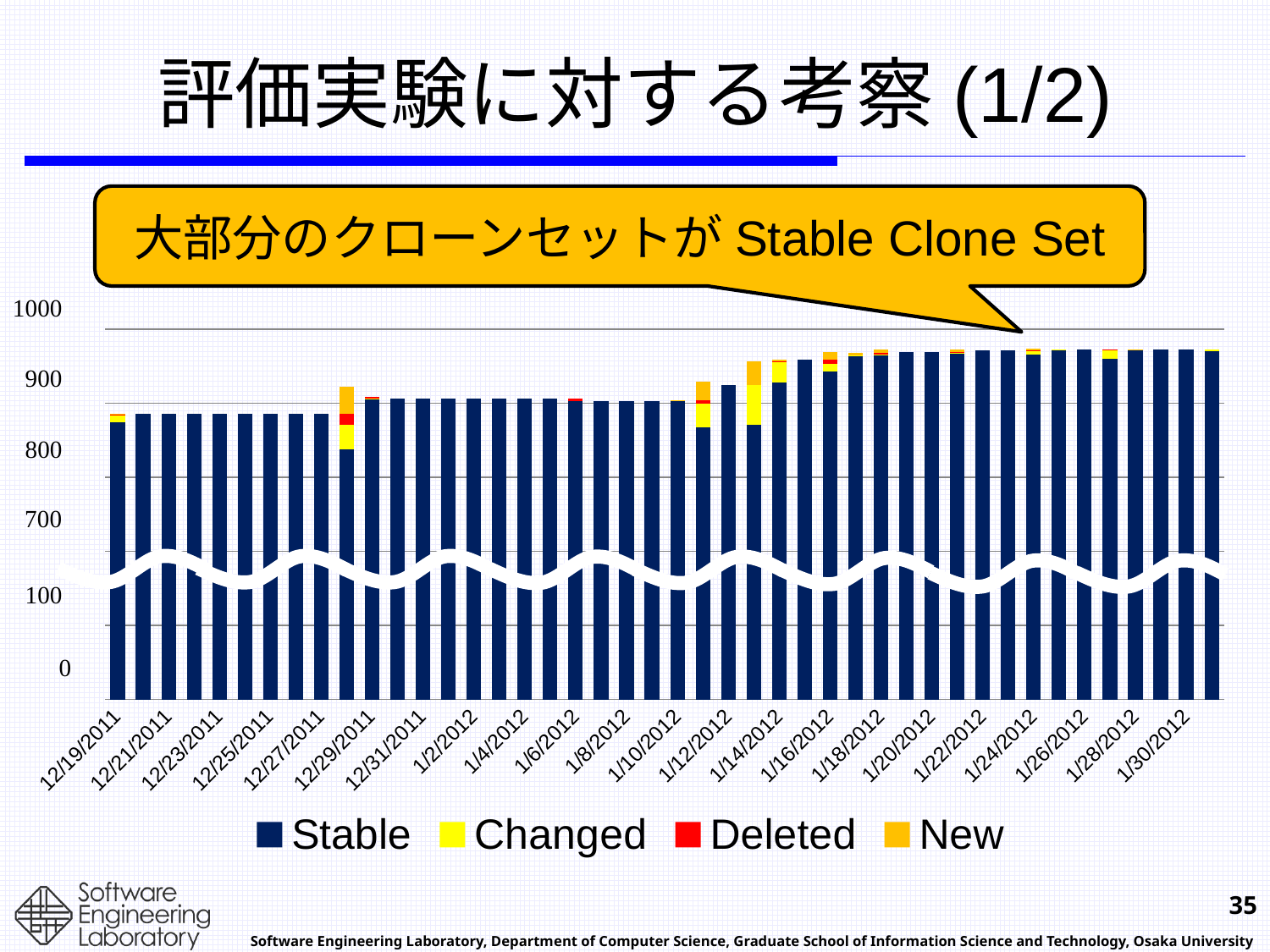
Which series makes up the largest part of every bar? Stable Do the bar totals generally rise or fall from 12/19/2011 to 1/30/2012? rise What colour represents the Stable series in the chart? dark blue Is the total value of the bar for 1/20/2012 greater or less than 1000? less Is the total value of the bar for 12/19/2011 greater or less than 900? less Is the total value of the bar for 1/30/2012 greater or less than 900? greater What kind of chart is shown on the slide? stacked bar chart Which series are listed in the chart legend? Stable, Changed, Deleted, New Which bar has the larger total, 12/19/2011 or 1/30/2012? 1/30/2012 How many series does the chart legend list? 4